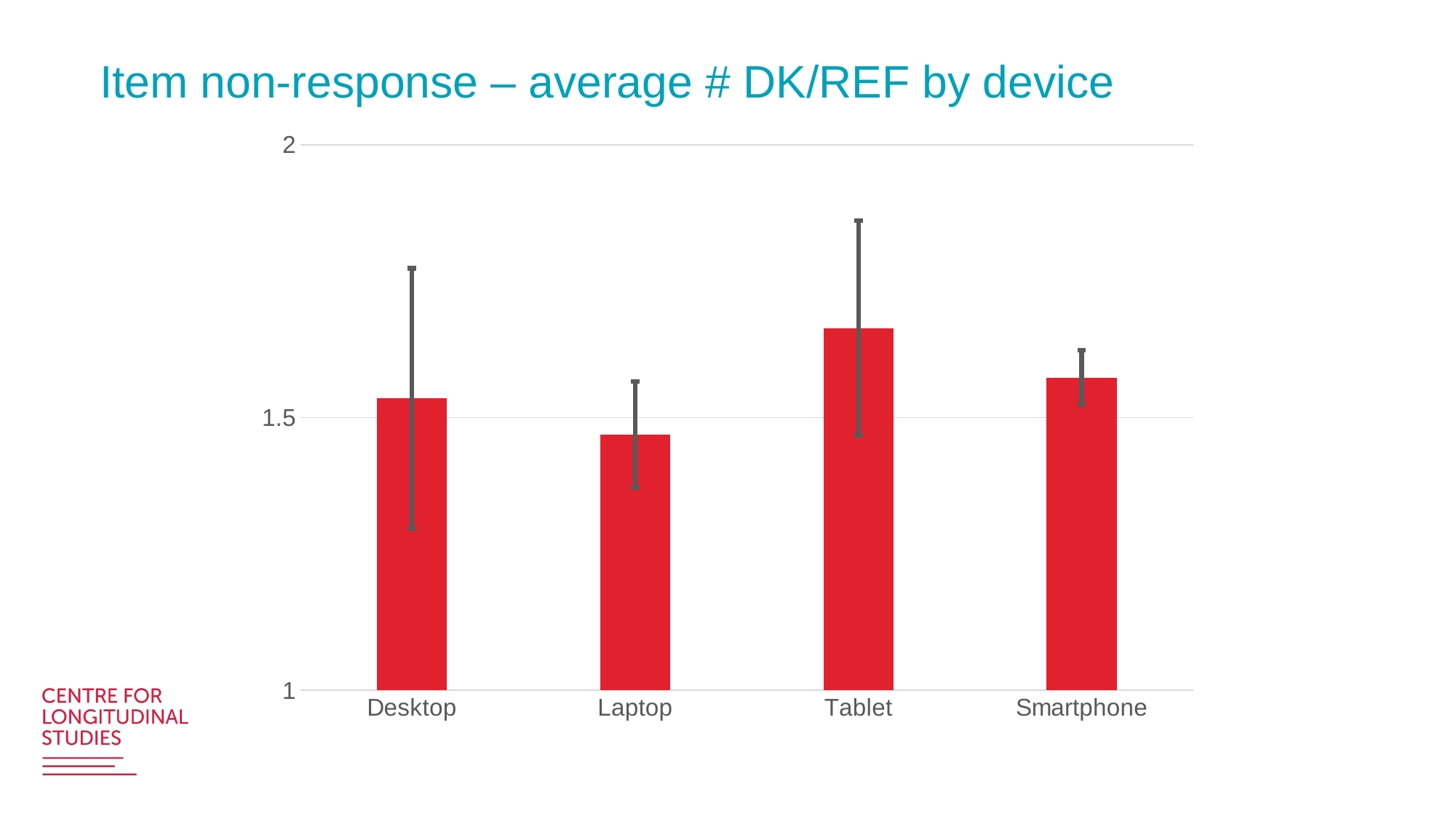
Which is larger, the value for Smartphone or the value for Laptop? Smartphone What kind of chart is shown on the slide? Bar chart Is the value for Laptop greater or less than 1.5? less Is the value for Smartphone greater or less than 1.5? greater What colour are the bars in the chart? Red Is the value for Tablet greater or less than 1.5? greater How many device categories are shown on the x axis? 4 Which device has the highest average number of DK/REF? Tablet Which device has the lowest average number of DK/REF? Laptop Which is larger, the value for Tablet or the value for Laptop? Tablet What is the title of the slide? Item non-response – average # DK/REF by device